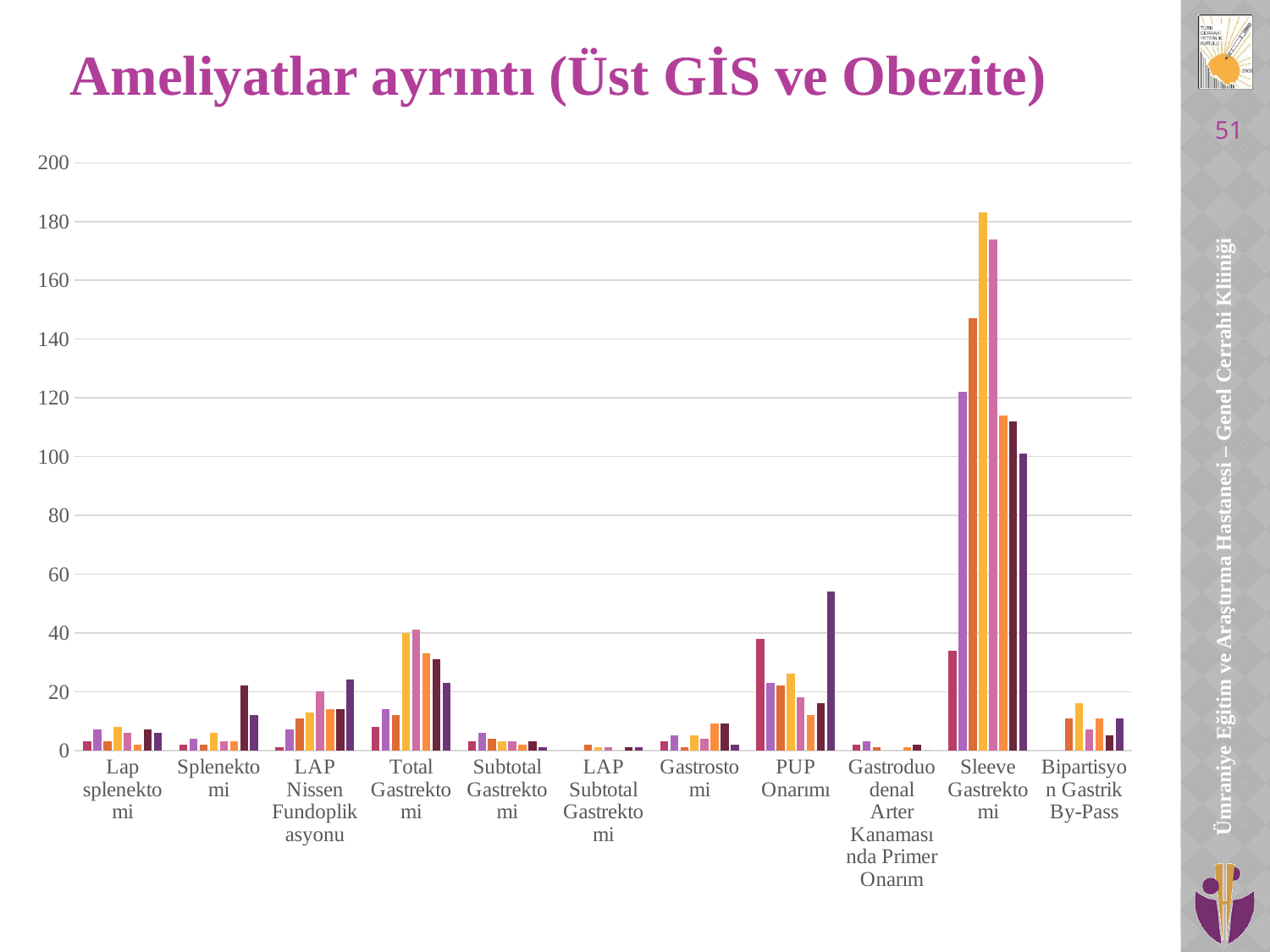
Which category has larger bars overall, Sleeve Gastrektomi or Total Gastrektomi? Sleeve Gastrektomi Is the tallest bar for Sleeve Gastrektomi greater or less than 160? greater What kind of chart is shown on the slide? bar chart Is the tallest bar for PUP Onarımı greater or less than 60? less What is the maximum value shown on the vertical axis of the chart? 200 Are all bars for Gastrostomi greater or less than 20? less Which category has the tallest bar in the chart? Sleeve Gastrektomi How many categories are shown along the x axis of the chart? 11 Which category has larger bars overall, PUP Onarımı or Subtotal Gastrektomi? PUP Onarımı What is the title of the chart? Ameliyatlar ayrıntı (Üst GİS ve Obezite)